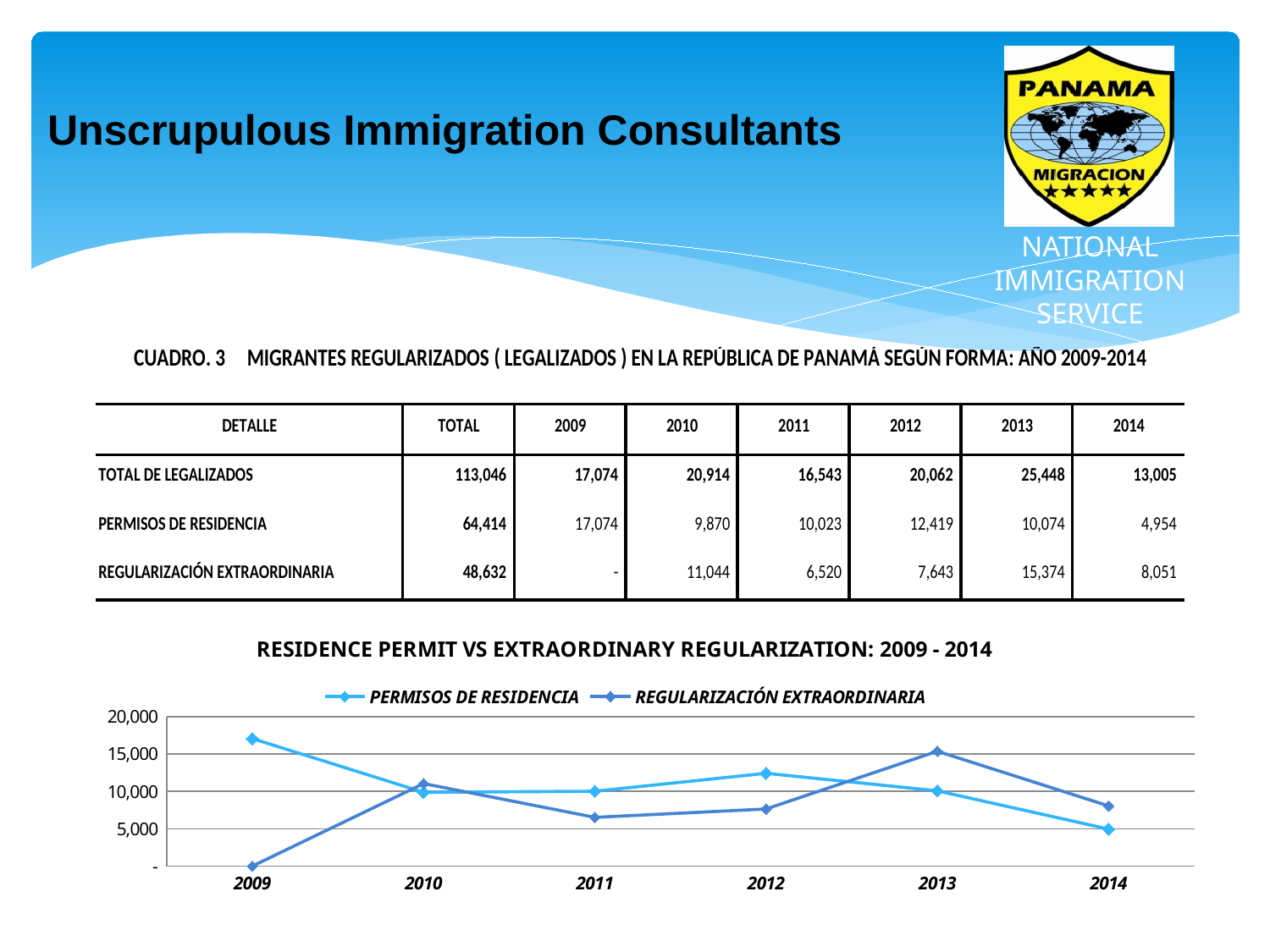
What kind of chart is shown under the title 'RESIDENCE PERMIT VS EXTRAORDINARY REGULARIZATION: 2009 - 2014'? line chart In the line chart, is the value for PERMISOS DE RESIDENCIA in 2009 greater or less than 15,000? greater How many years are plotted along the x axis of the line chart? 6 How many series does the legend of the line chart list? 2 In the line chart, does the PERMISOS DE RESIDENCIA line rise or fall from 2013 to 2014? fall Using the values in the table, how much larger is REGULARIZACIÓN EXTRAORDINARIA than PERMISOS DE RESIDENCIA in 2013? 5,300 In the line chart, which year has the lowest value for PERMISOS DE RESIDENCIA? 2014 In the line chart, which year has the highest value for REGULARIZACIÓN EXTRAORDINARIA? 2013 In the line chart, is the value for REGULARIZACIÓN EXTRAORDINARIA in 2011 greater or less than 10,000? less In the line chart, which year has the highest value for PERMISOS DE RESIDENCIA? 2009 In the line chart, which series has the larger value in 2013, PERMISOS DE RESIDENCIA or REGULARIZACIÓN EXTRAORDINARIA? REGULARIZACIÓN EXTRAORDINARIA According to the table on the slide, what is the value of PERMISOS DE RESIDENCIA for 2012? 12,419